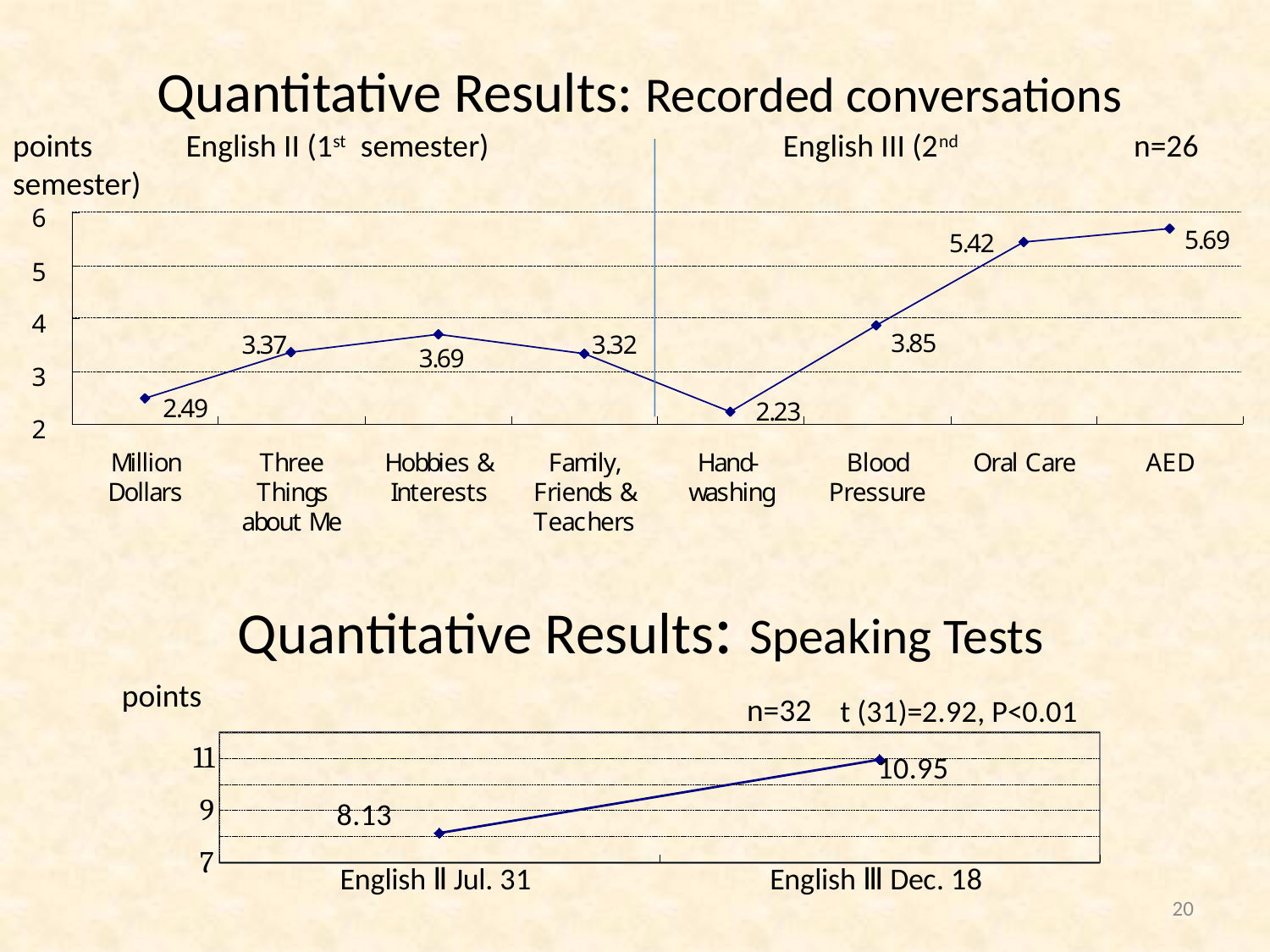
In the Recorded conversations chart, how many categories are plotted? 8 In the Recorded conversations chart, which category has the lowest value? Hand-washing In the Speaking Tests chart, what is the value for English III Dec. 18? 10.95 In the Speaking Tests chart, do the values rise or fall from English II Jul. 31 to English III Dec. 18? rise In the Speaking Tests chart, how many data points are plotted? 2 In the Recorded conversations chart, what is the value for Oral Care? 5.42 In the Recorded conversations chart, which category has the highest value? AED What kind of chart is the Recorded conversations chart? line chart In the Speaking Tests chart, what is the difference between the values for English III Dec. 18 and English II Jul. 31? 2.82 In the Recorded conversations chart, what is the difference between the values for AED and Million Dollars? 3.20 In the Recorded conversations chart, what is the value for Hand-washing? 2.23 In the Recorded conversations chart, which is larger, the value for Hobbies & Interests or the value for Blood Pressure? Blood Pressure